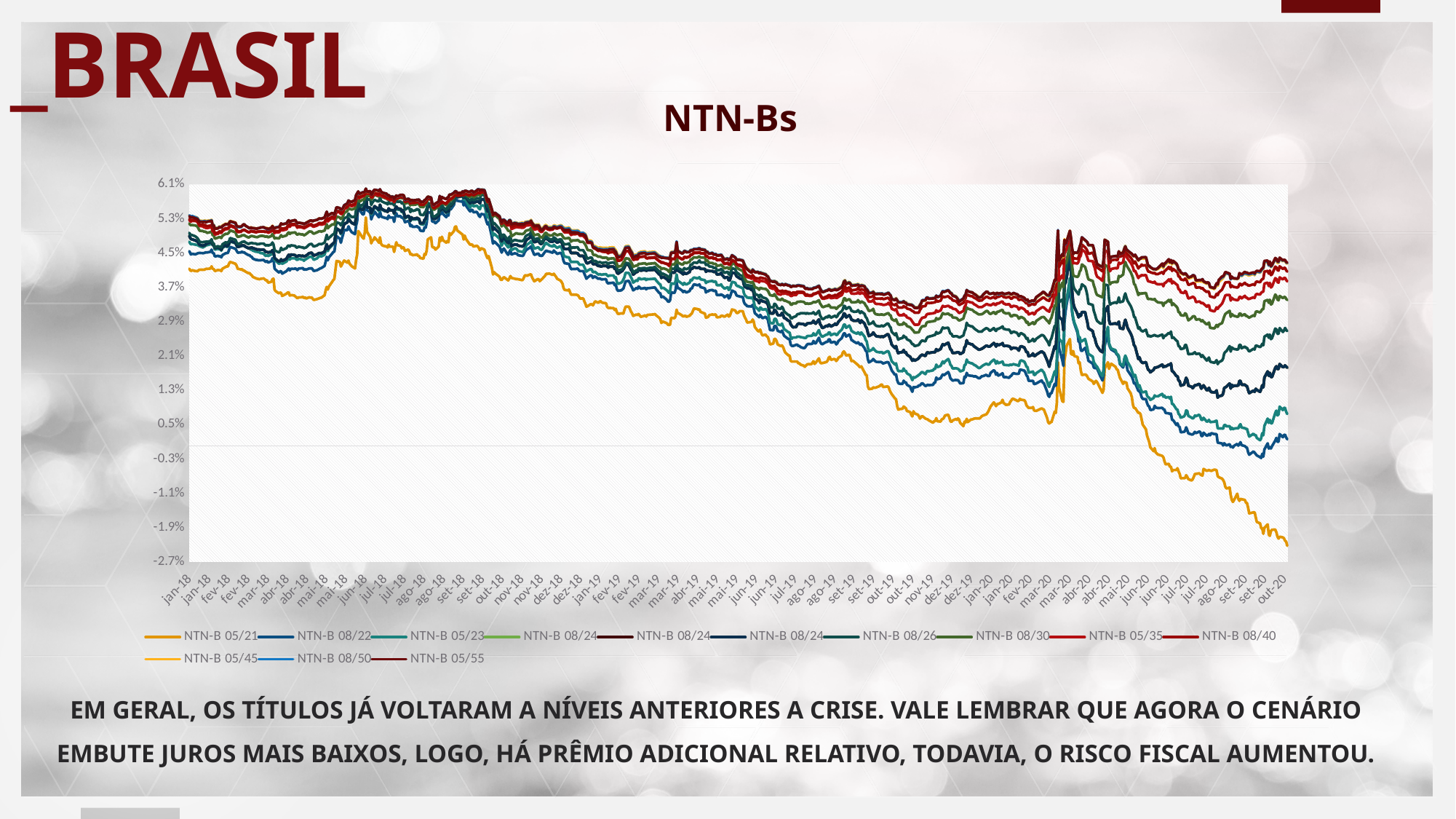
Is the value of NTN-B 05/21 at out-20 greater or less than -1.1%? less Which series has the lowest value at the end of the chart (out-20)? NTN-B 05/21 Which series is plotted in orange according to the legend? NTN-B 05/21 What kind of chart is shown on the slide? line chart Does the NTN-B 05/21 line overall rise or fall from jan-18 to out-20? fall Is the value of NTN-B 05/21 at set-18 greater or less than 3.7%? greater Is the value of NTN-B 05/21 at jan-18 greater or less than 2.1%? greater What is the highest value shown on the vertical axis? 6.1% What is the title of the chart? NTN-Bs Which is larger at out-20: the value of NTN-B 05/21 or the value of NTN-B 05/55? NTN-B 05/55 How many series does the chart's legend list? 13